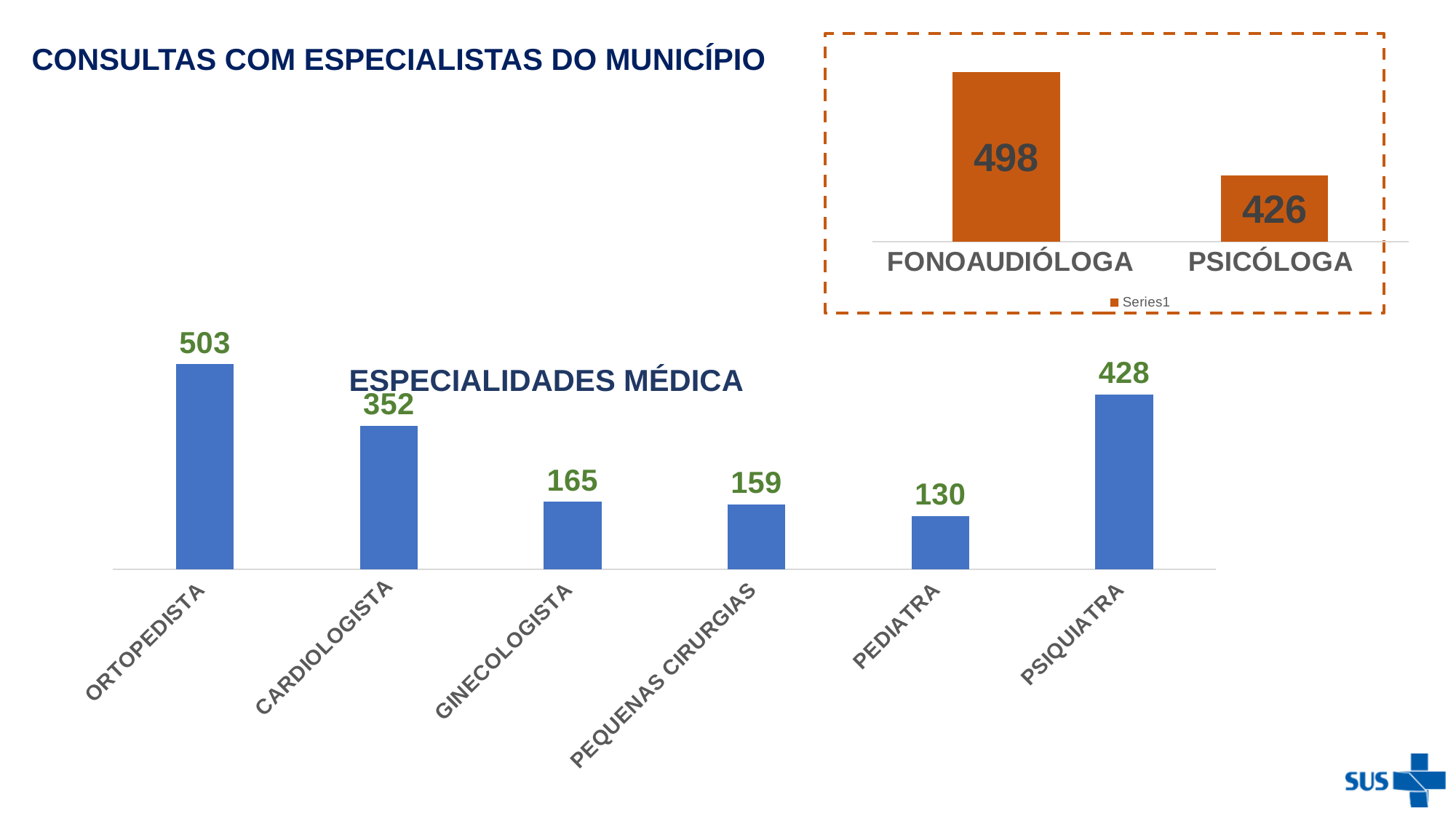
In the top-right chart, what is the difference between FONOAUDIÓLOGA and PSICÓLOGA? 72 In the ESPECIALIDADES MÉDICA chart, what is the difference between the values for ORTOPEDISTA and PSIQUIATRA? 75 What legend entry is shown in the top-right chart? Series1 In the ESPECIALIDADES MÉDICA chart, which is larger, CARDIOLOGISTA or GINECOLOGISTA? CARDIOLOGISTA What kind of chart is the ESPECIALIDADES MÉDICA chart? Bar chart In the ESPECIALIDADES MÉDICA chart, which category has the highest value? ORTOPEDISTA In the ESPECIALIDADES MÉDICA chart, what is the value for ORTOPEDISTA? 503 In the top-right chart, what is the value for PSICÓLOGA? 426 In the ESPECIALIDADES MÉDICA chart, which category has the lowest value? PEDIATRA How many categories are shown in the ESPECIALIDADES MÉDICA chart? 6 In the ESPECIALIDADES MÉDICA chart, what is the value for PEDIATRA? 130 In the top-right chart, what is the value for FONOAUDIÓLOGA? 498